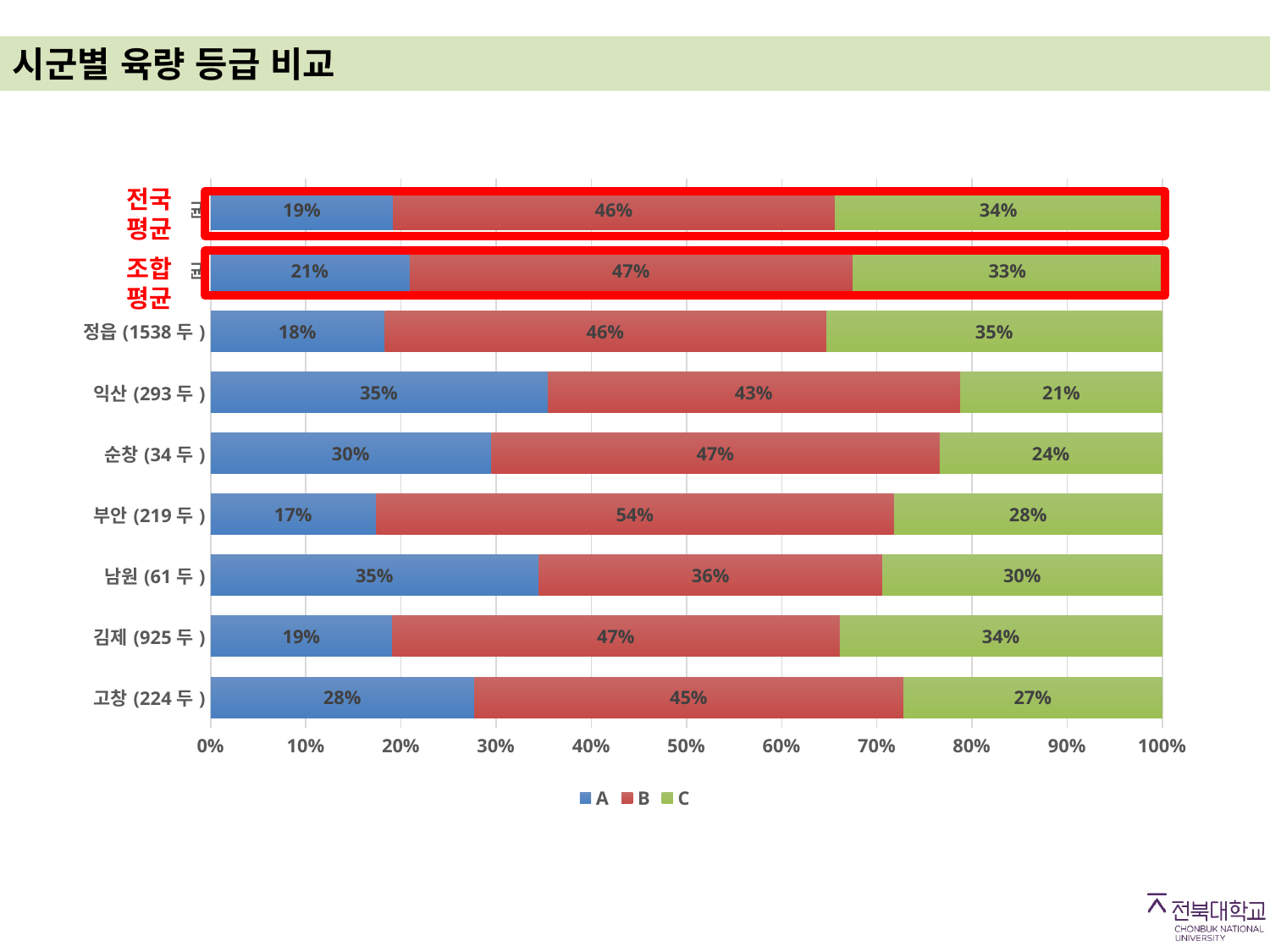
What is the value of series A for 전국 평균? 19% How many categories are shown on the chart? 9 What is the value of series C for 조합 평균? 33% Which category has the lowest value for series A? 부안 (219 두) Which category has the highest value for series B? 부안 (219 두) What is the value of series A for 익산 (293 두)? 35% What is the difference between the series B values for 부안 (219 두) and 남원 (61 두)? 18 percentage points What kind of chart is shown on the slide? Stacked bar chart Which is larger: the series C value for 정읍 (1538 두) or for 고창 (224 두)? 정읍 (1538 두) What is the value of series B for 부안 (219 두)? 54% How many series does the legend list? 3 Which category has the lowest value for series C? 익산 (293 두)